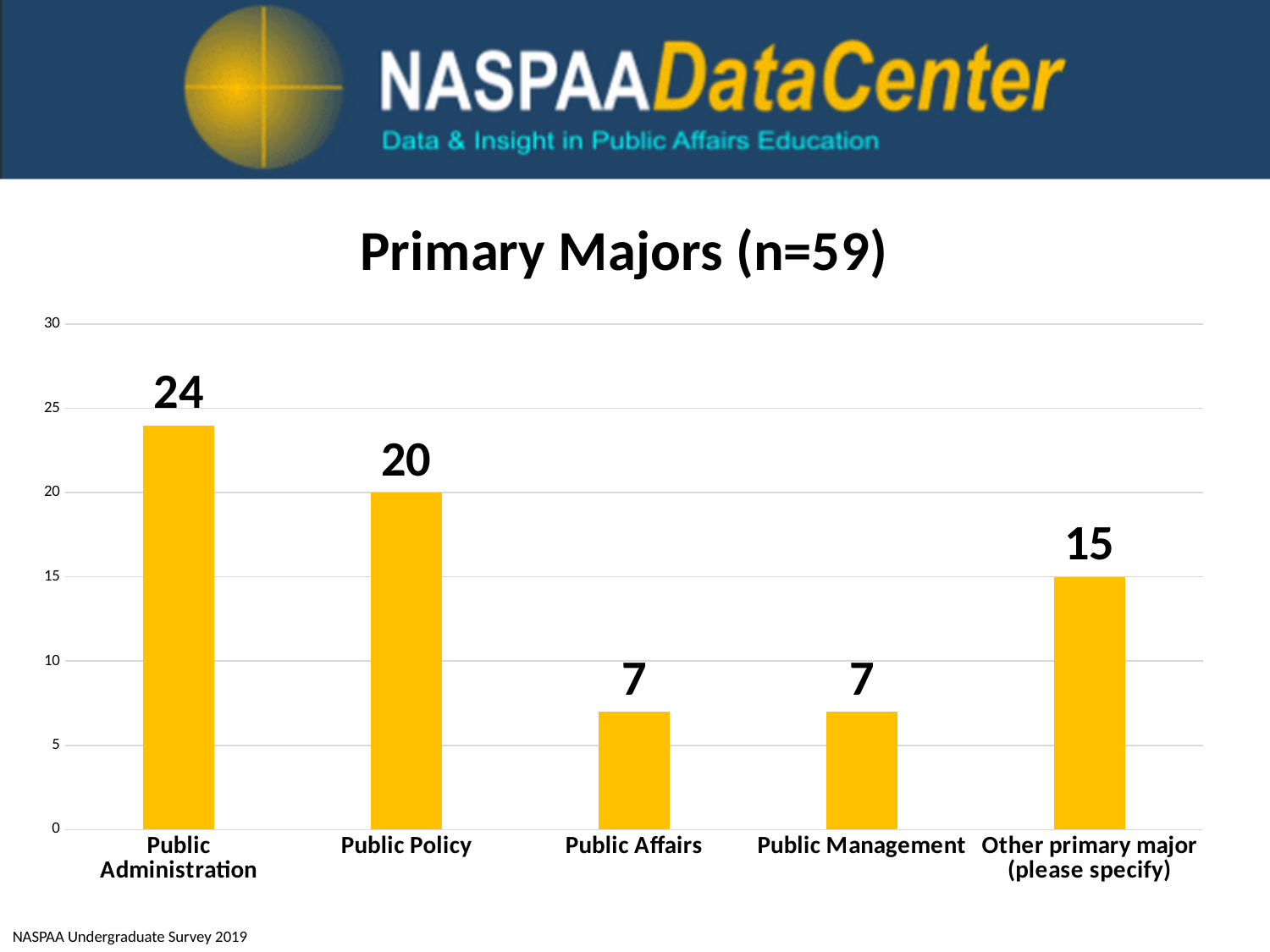
What is the difference between the values for Public Administration and Public Policy? 4 What is the value for Public Administration? 24 How many categories are shown on the x axis? 5 What is the value for Public Management? 7 Is the value for Public Affairs greater or less than 10? less Which category has the highest value? Public Administration What kind of chart is shown on the slide? bar chart Which is larger, the value for Public Policy or the value for Other primary major (please specify)? Public Policy What is the difference between the values for Public Policy and Other primary major (please specify)? 5 What is the value for Other primary major (please specify)? 15 What is the value for Public Policy? 20 What is the title of the chart? Primary Majors (n=59)